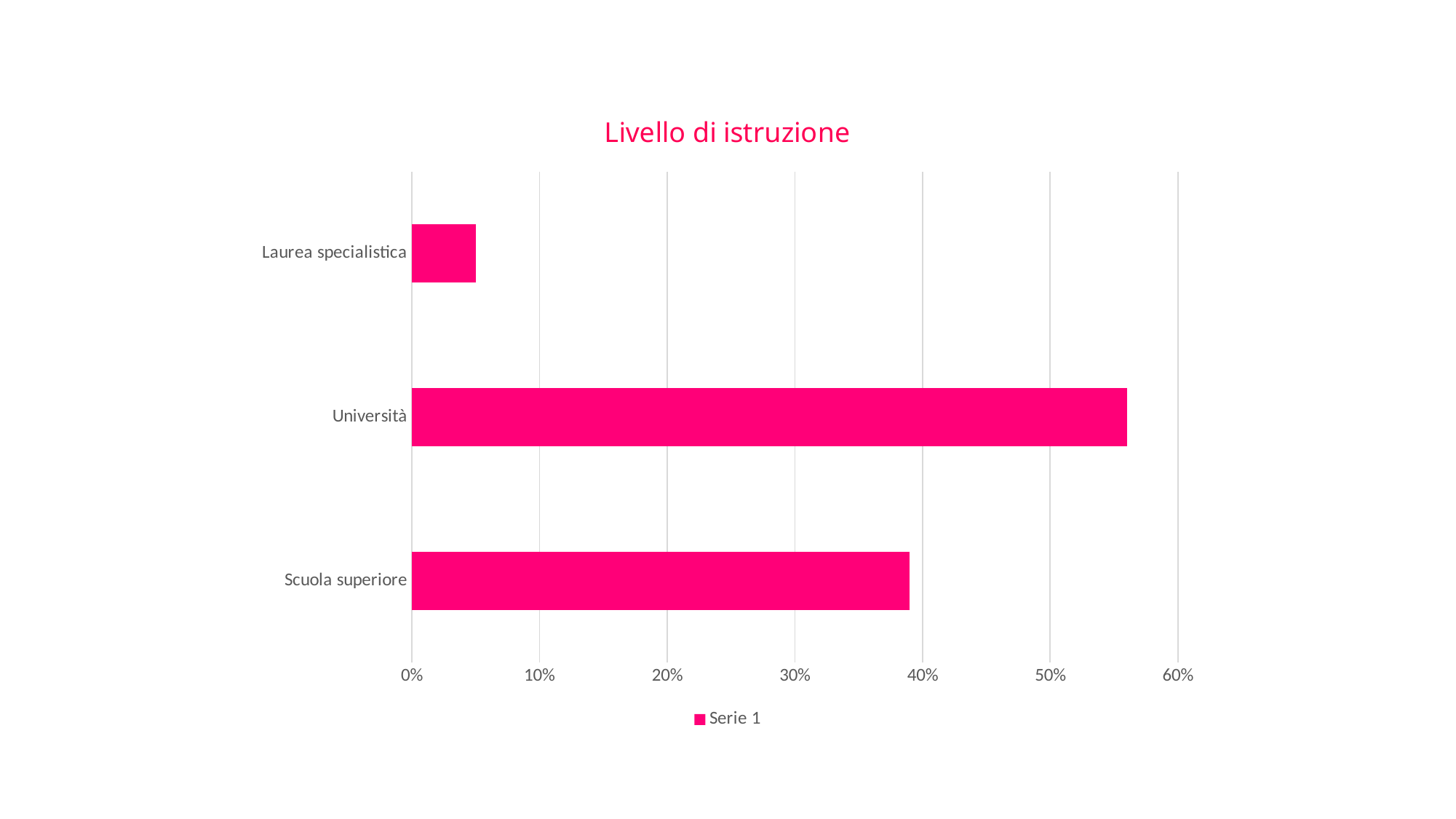
What type of chart is shown on the slide? bar chart How many series does the legend list? 1 What is the name of the series shown in the legend? Serie 1 Is the value for Laurea specialistica greater or less than 10%? less Which is larger, the value for Scuola superiore or the value for Laurea specialistica? Scuola superiore Which category has the lowest value? Laurea specialistica Which is larger, the value for Università or the value for Scuola superiore? Università What is the title of the chart? Livello di istruzione Which category has the highest value? Università Is the value for Scuola superiore greater or less than 30%? greater Is the value for Università greater or less than 50%? greater How many categories are shown in the chart? 3